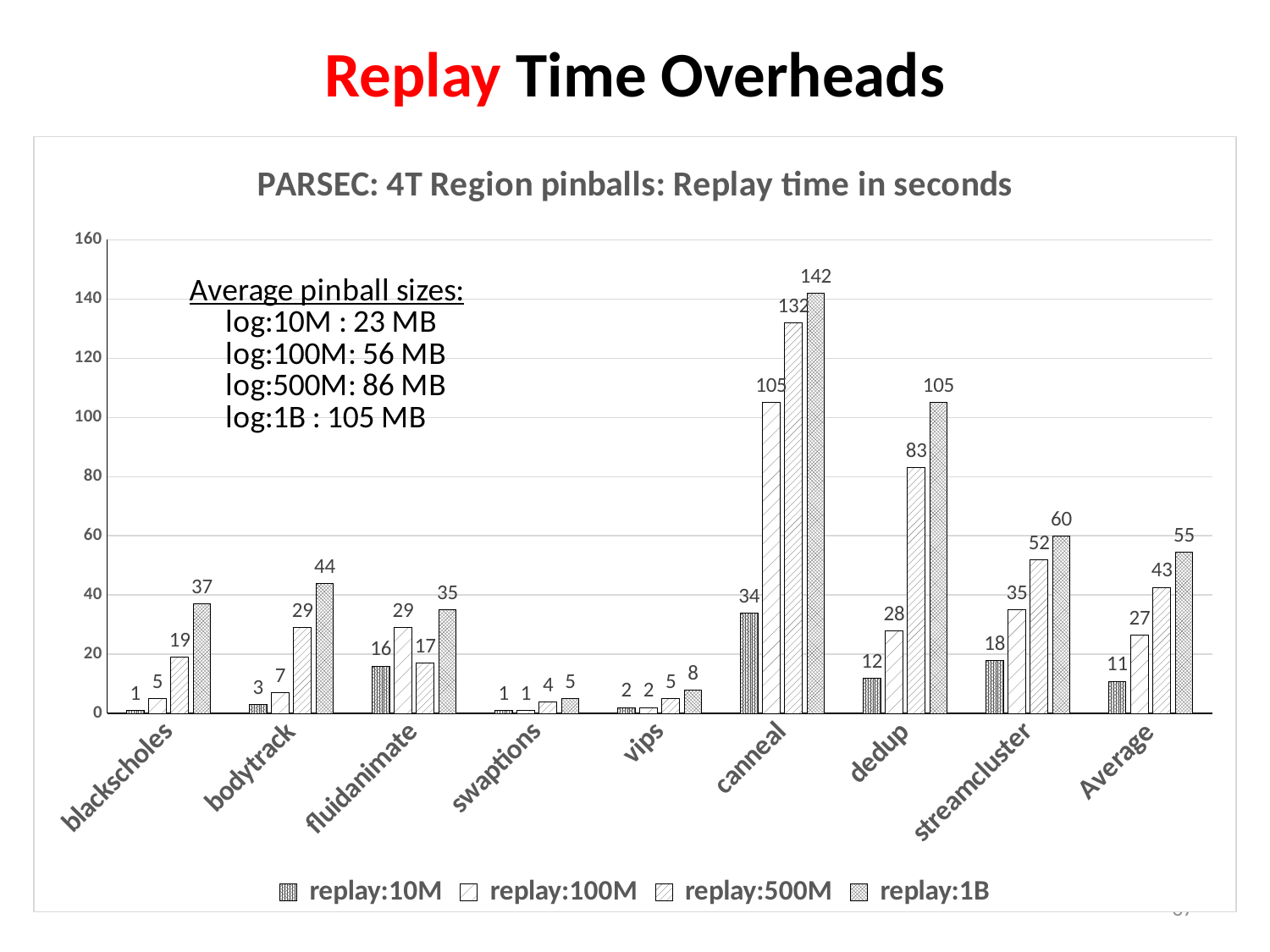
What is the replay:10M value for fluidanimate? 16 Which category has the lowest replay:1B value? swaptions What is the replay:500M value for dedup? 83 Which category has the highest replay:1B value? canneal Which is larger for dedup: the replay:500M value or the replay:100M value? replay:500M What kind of chart is shown on the slide? bar chart How many series does the legend list? 4 What is the replay:100M value for Average? 27 What is the replay:1B value for canneal? 142 What is the difference between the replay:1B and replay:10M values for streamcluster? 42 What is the title of the chart? PARSEC: 4T Region pinballs: Replay time in seconds How many categories are shown on the x axis? 9